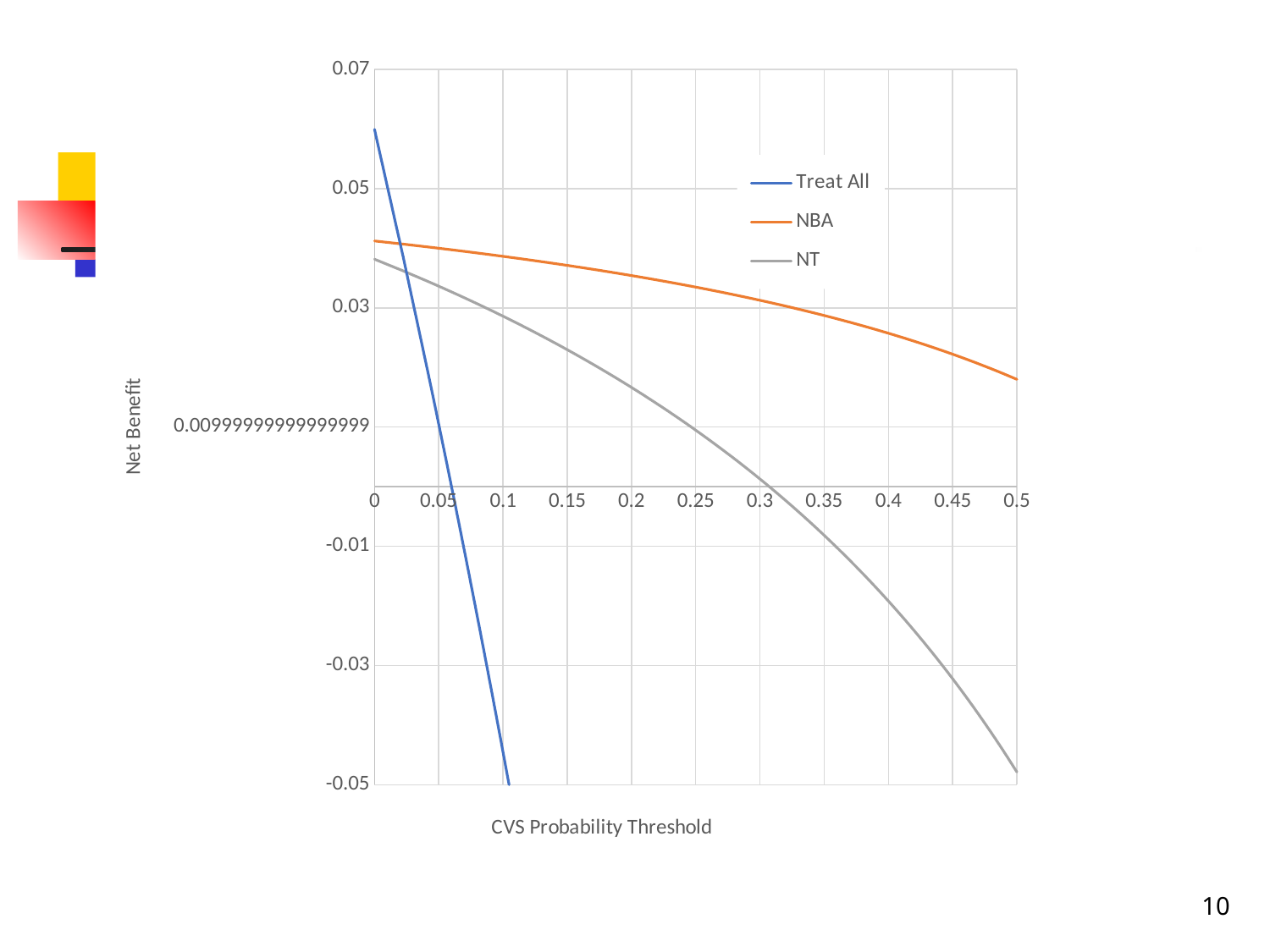
Is the value of the Treat All line at a threshold of 0 greater or less than 0.05? greater Is the value of the NT line at a threshold of 0.5 greater or less than -0.03? less What kind of chart is shown on the slide? line chart How many series does the legend list? 3 What is the title of the x axis? CVS Probability Threshold Is the value of the NBA line at a threshold of 0.5 greater or less than 0.01? greater Does the Treat All line rise or fall along the x axis? fall Which series has the highest net benefit at a threshold of 0? Treat All Does the NBA line rise or fall as the CVS Probability Threshold increases? fall At a threshold of 0.3, which series has the higher net benefit, NBA or NT? NBA What are the series names listed in the legend? Treat All, NBA, NT